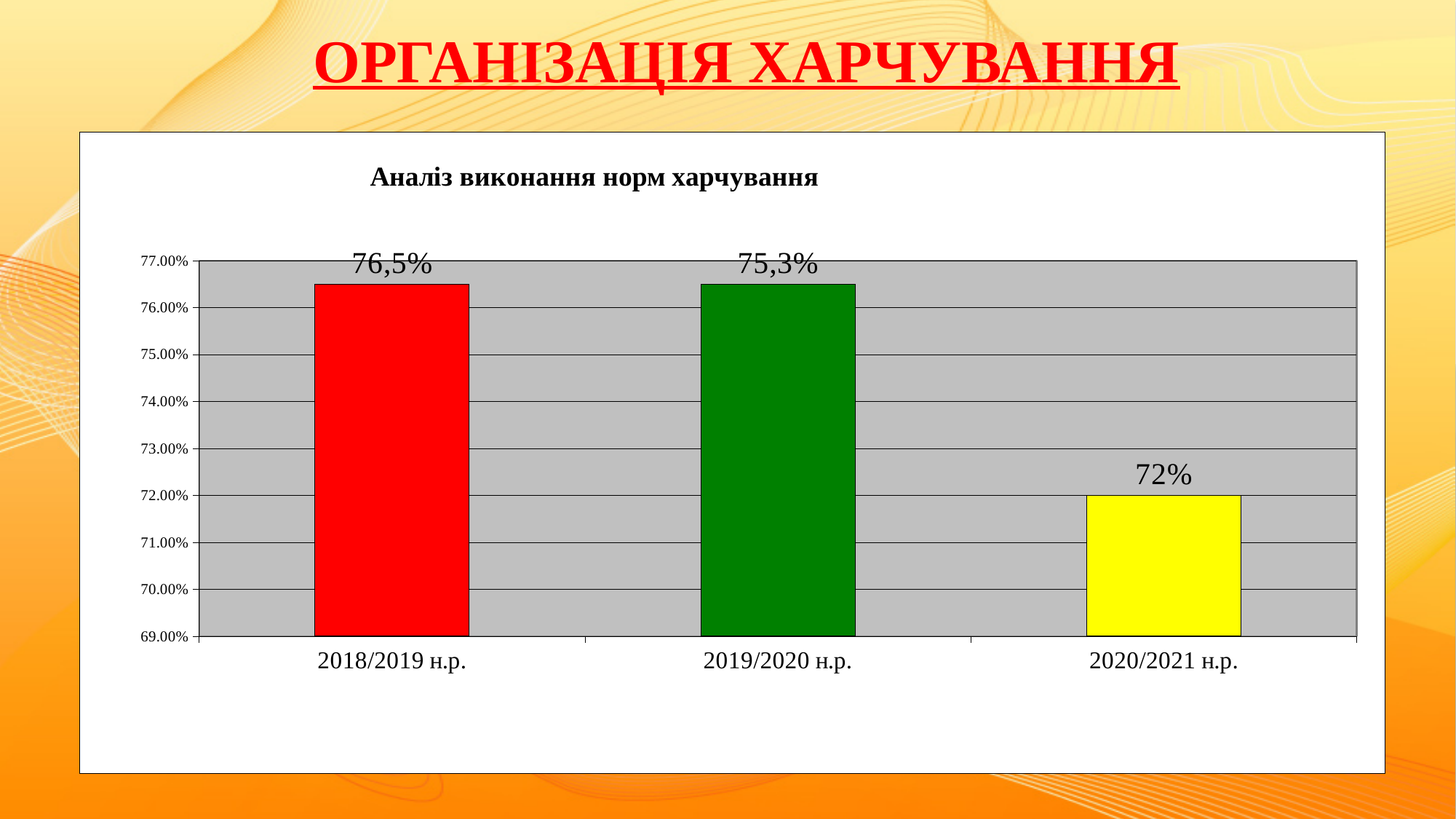
Which is larger, the value for 2019/2020 н.р. or the value for 2020/2021 н.р.? 2019/2020 н.р. Do the values rise or fall from 2018/2019 н.р. to 2020/2021 н.р.? fall How many years are shown on the chart? 3 What is the value for 2020/2021 н.р.? 72% What is the difference between the values for 2019/2020 н.р. and 2020/2021 н.р.? 3,3% Which year has the lowest value? 2020/2021 н.р. What is the value for 2019/2020 н.р.? 75,3% What kind of chart is shown on the slide? bar chart What is the value for 2018/2019 н.р.? 76,5% What is the difference between the values for 2018/2019 н.р. and 2020/2021 н.р.? 4,5% Is the value for 2020/2021 н.р. greater or less than 73.00%? less Which year has the highest value according to the data labels? 2018/2019 н.р.